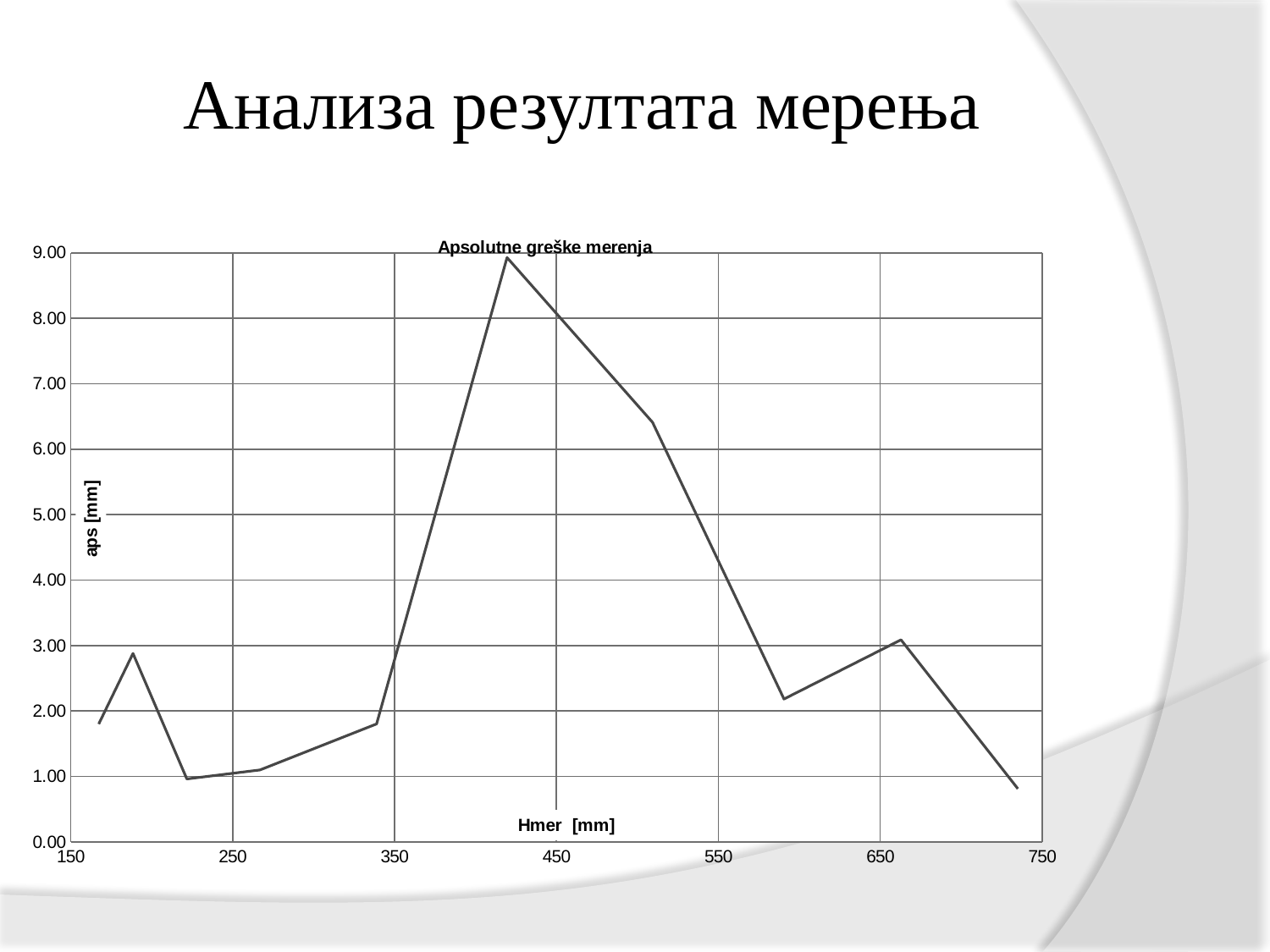
Is the value of the point near 650 mm greater or less than 4.00? less What is the label of the x axis of the chart? Hmer [mm] Is the value of the last point on the line (near 750 mm) greater or less than 2.00? less How many data points are plotted on the line? 10 Is the value of the point just after the 450 tick (around 510 mm) greater or less than 6.00? greater Between which two x-axis ticks does the peak of the line occur? 350 and 450 What is the maximum value shown on the y axis? 9.00 What kind of chart is shown on the slide? line chart What is the title of the chart? Apsolutne greške merenja Which is larger: the value of the point near 510 mm or the value of the point near 590 mm? the point near 510 mm